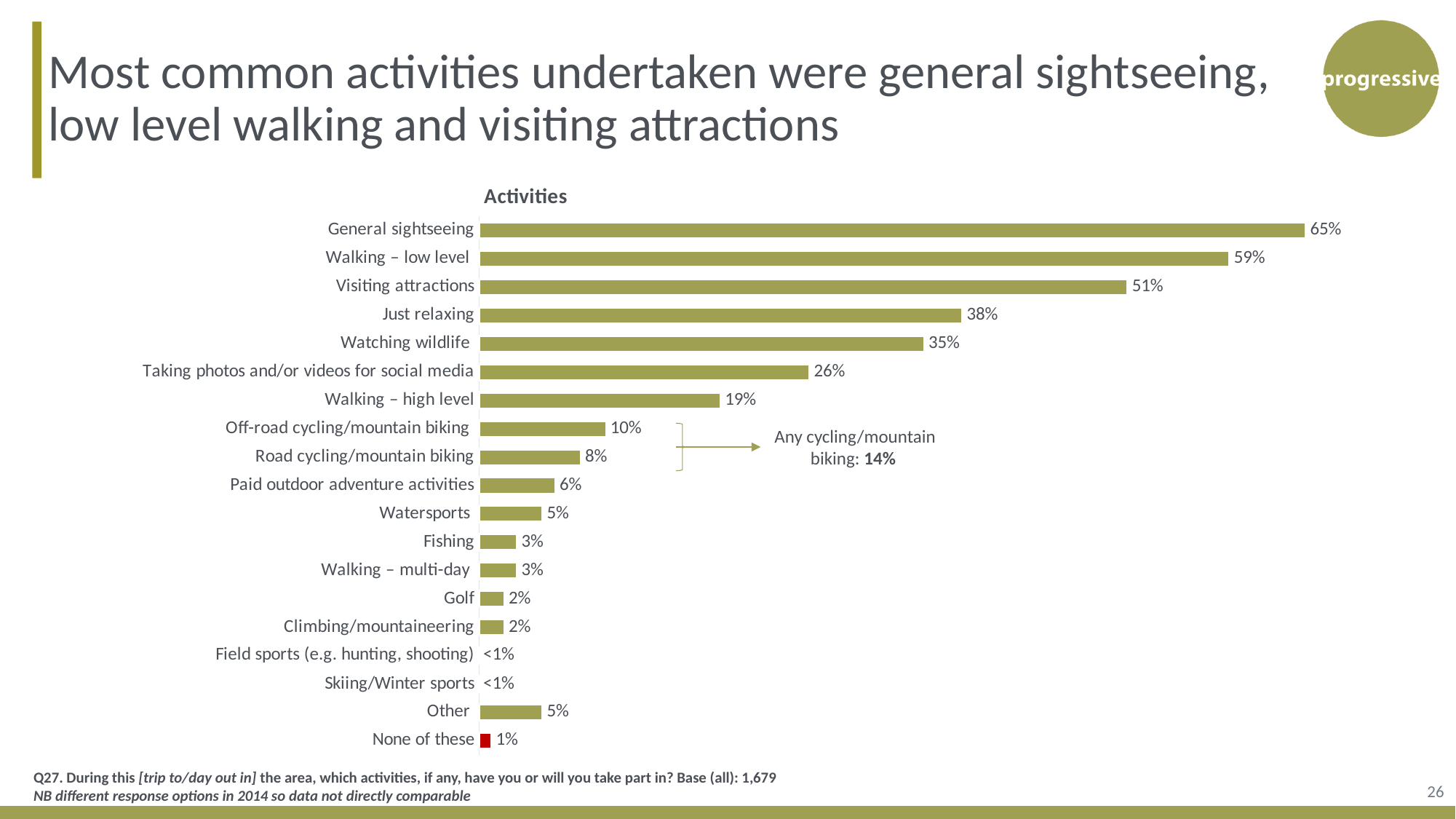
Which is larger, Just relaxing or Visiting attractions? Visiting attractions How many activity categories are shown in the chart? 19 Which activity has the highest value? General sightseeing What is the value for Taking photos and/or videos for social media? 26% What is the difference between Walking – low level and Walking – high level? 40 percentage points What is the title of the chart? Activities What is the combined value shown for any cycling/mountain biking? 14% What is the difference between Off-road cycling/mountain biking and Road cycling/mountain biking? 2 percentage points What is the value for None of these? 1% What percentage of respondents took part in general sightseeing? 65% What is the value for Watching wildlife? 35% What type of chart is shown on the slide? Bar chart